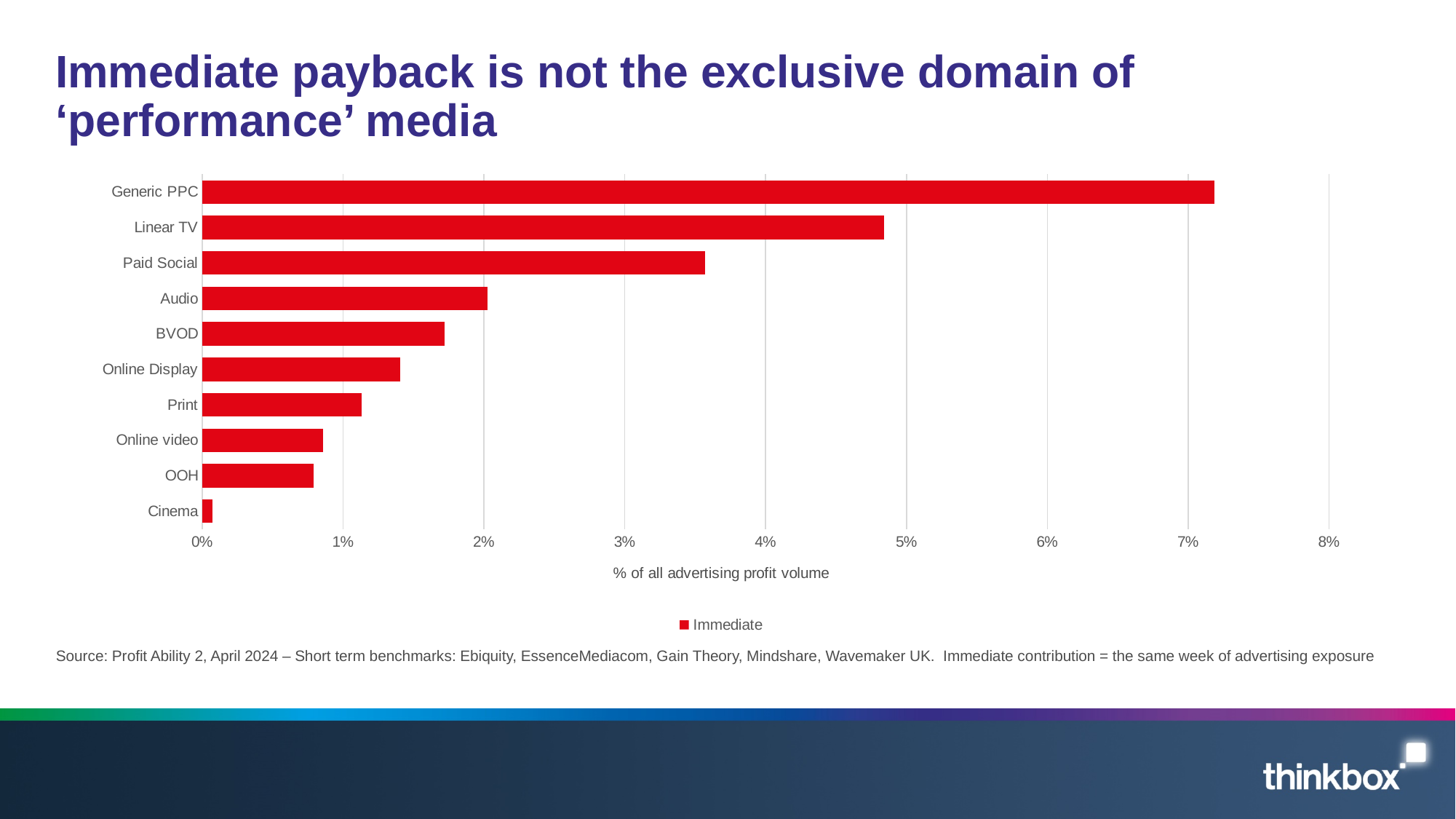
How many series does the legend list? 1 Is the value for Online video greater or less than 1%? less What kind of chart is shown on the slide? Bar chart Is the value for Linear TV greater or less than 5%? less Is the value for BVOD greater or less than 2%? less What is the title of the x axis? % of all advertising profit volume How many categories are plotted on the chart? 10 Which is larger, the value for Linear TV or the value for Paid Social? Linear TV Which category has the lowest value? Cinema Which category has the highest value? Generic PPC